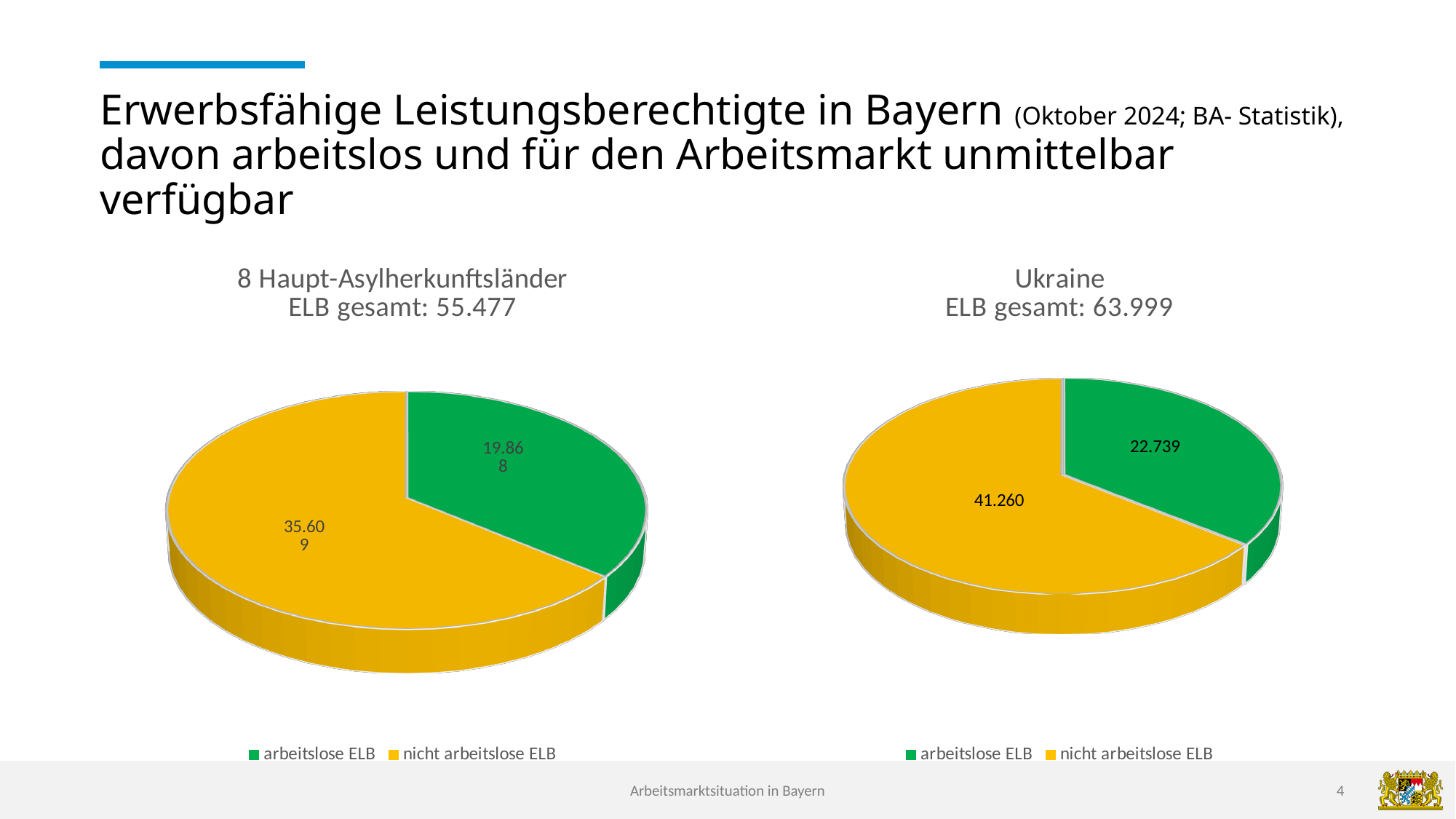
In the left pie chart (8 Haupt-Asylherkunftsländer), what is the difference between nicht arbeitslose ELB and arbeitslose ELB? 15.741 In the left pie chart (8 Haupt-Asylherkunftsländer), what is the value for arbeitslose ELB? 19.868 In the right pie chart (Ukraine), what is the difference between nicht arbeitslose ELB and arbeitslose ELB? 18.521 What type of chart is used on this slide? pie chart In the right pie chart (Ukraine), what is the value for arbeitslose ELB? 22.739 In the right pie chart (Ukraine), which slice is the largest? nicht arbeitslose ELB In the right pie chart (Ukraine), what is the value for nicht arbeitslose ELB? 41.260 How many slices does the right pie chart (Ukraine) have? 2 Which chart has the larger value for arbeitslose ELB, the left chart (8 Haupt-Asylherkunftsländer) or the right chart (Ukraine)? Ukraine In the left pie chart (8 Haupt-Asylherkunftsländer), which slice is the smallest? arbeitslose ELB What is the ELB gesamt total stated in the title of the left pie chart? 55.477 In the left pie chart (8 Haupt-Asylherkunftsländer), what is the value for nicht arbeitslose ELB? 35.609